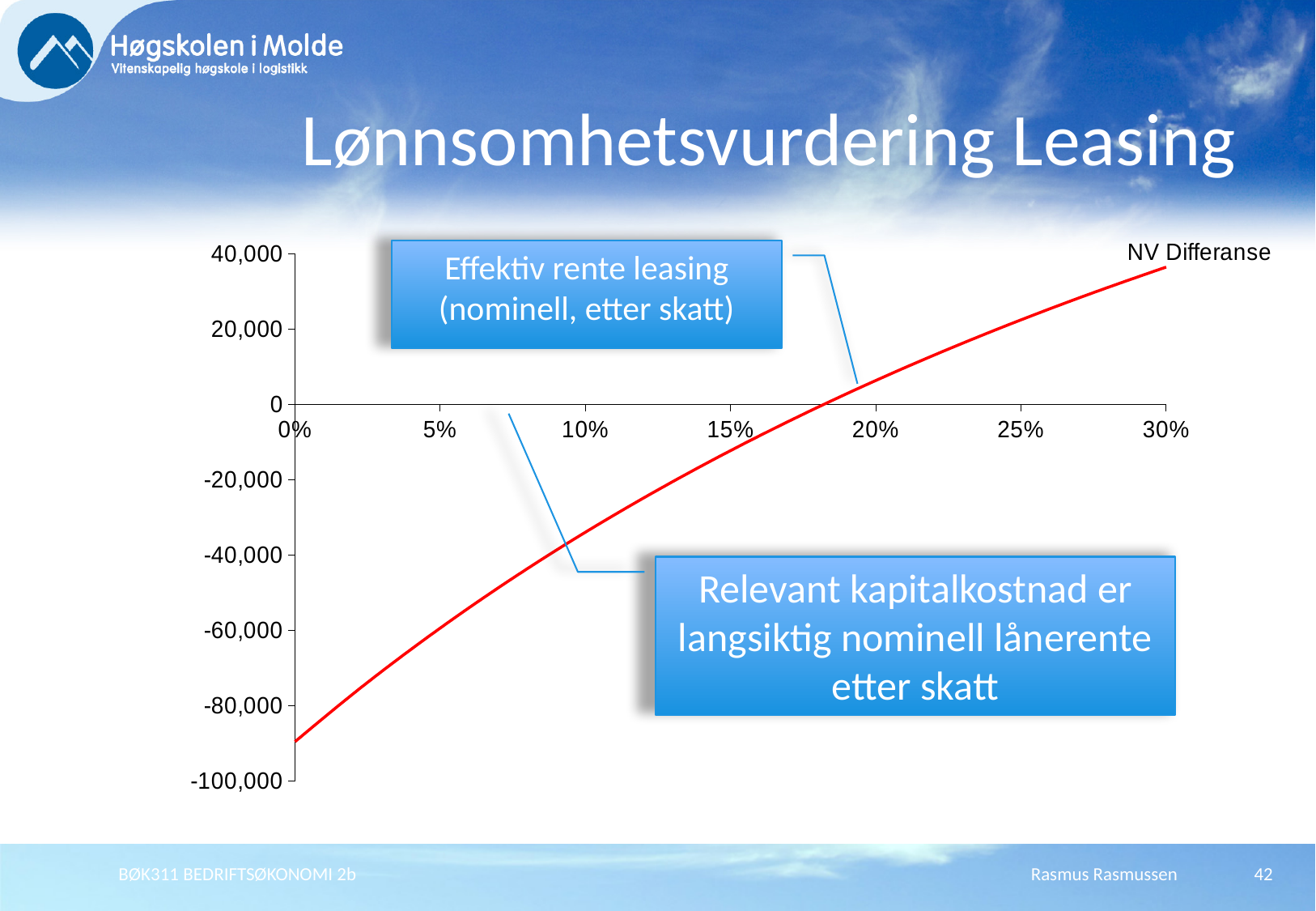
Is the value of NV Differanse at 20% greater or less than 0? greater Which is larger, the NV Differanse at 25% or at 5%? 25% Is the value of NV Differanse at 0% greater or less than -80,000? less What kind of chart is shown on the slide? line chart What is the highest value shown on the y axis? 40,000 How many tick marks are labelled on the x axis? 7 Is the value of NV Differanse at 10% greater or less than -20,000? less Does the NV Differanse curve rise or fall as the interest rate increases along the x axis? rise What is the label of the plotted series? NV Differanse